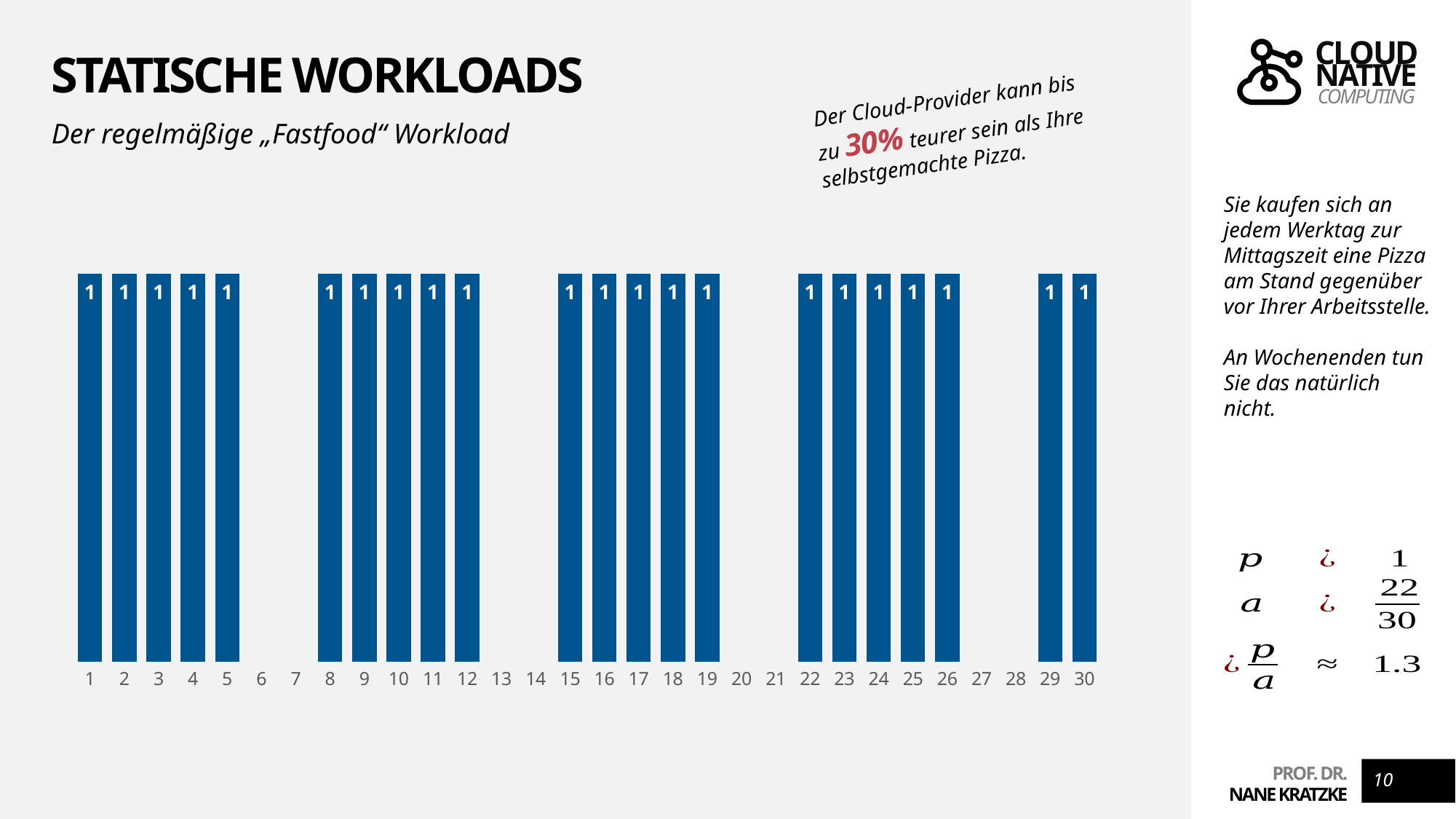
What kind of chart is shown on the slide? bar chart What is the value of the bar for category 30? 1 What colour are the bars in the chart? blue Do the values of the plotted bars rise, fall, or stay the same across the x axis? stay the same Is there a bar plotted for category 29? Yes What is the difference between the value for category 1 and the value for category 2? 0 Which is larger, the value for category 5 or the value for category 7? category 5 What is the value of the bar for category 16? 1 What is the value of the bar for category 3? 1 How many categories are shown on the x axis of the chart? 30 How many bars are plotted in the chart? 22 Is there a bar plotted for category 6? No